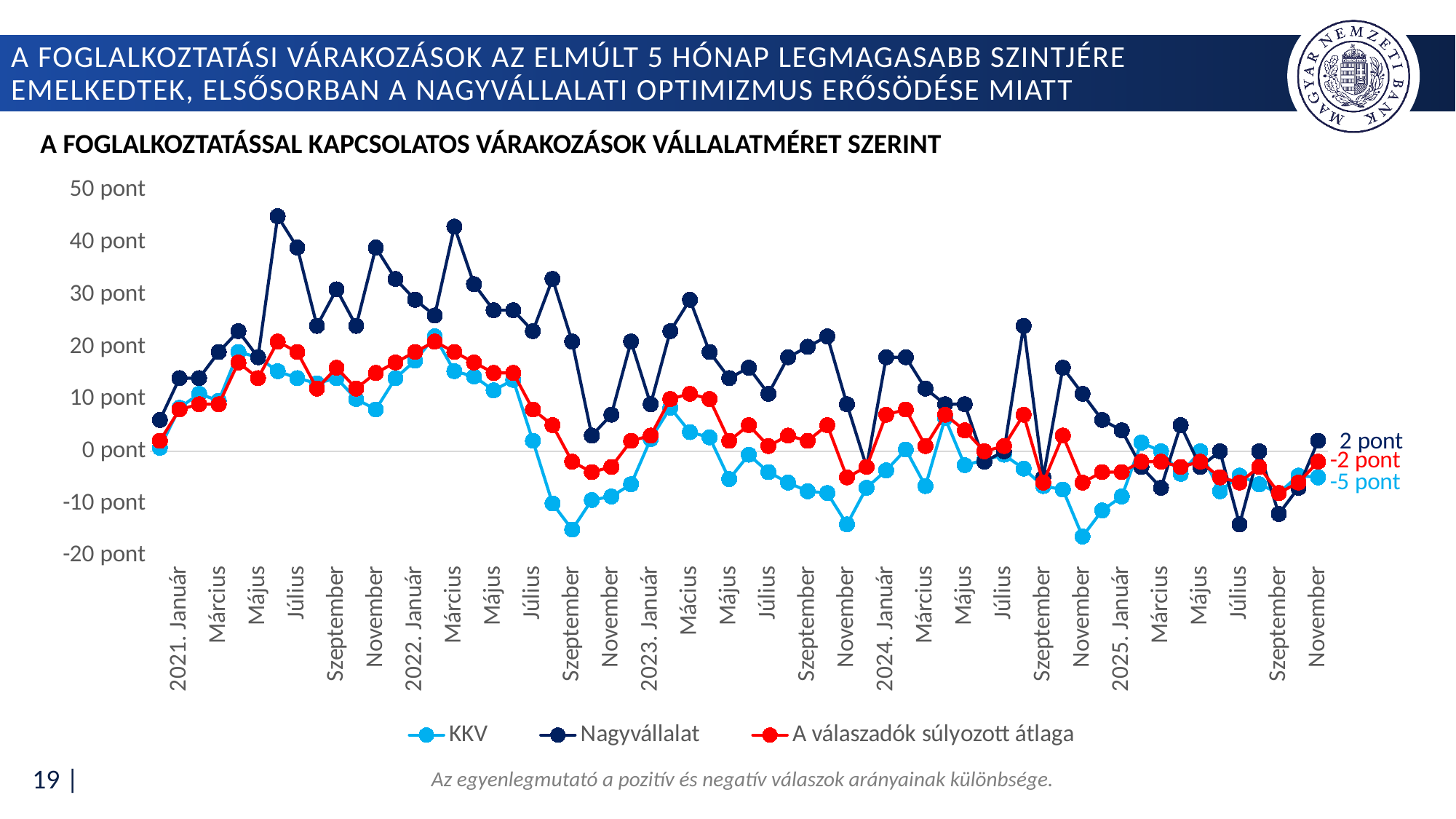
How many series does the legend list? 3 At the last data point, which series is higher: KKV or Nagyvállalat? Nagyvállalat Which series reaches the lowest value anywhere on the chart? KKV Is the highest value reached by the Nagyvállalat series greater or less than 40 pont? greater At the last data point, what is the difference between the Nagyvállalat value and the KKV value? 7 pont What is the latest value shown for the Nagyvállalat series? 2 pont Which series reaches the highest value anywhere on the chart? Nagyvállalat What is the title of the chart? A foglalkoztatással kapcsolatos várakozások vállalatméret szerint What is the latest value shown for the KKV series? -5 pont What is the latest value shown for the series 'A válaszadók súlyozott átlaga'? -2 pont What kind of chart is shown on the slide? Line chart Is the KKV value in 2022 Szeptember greater or less than -10 pont? less